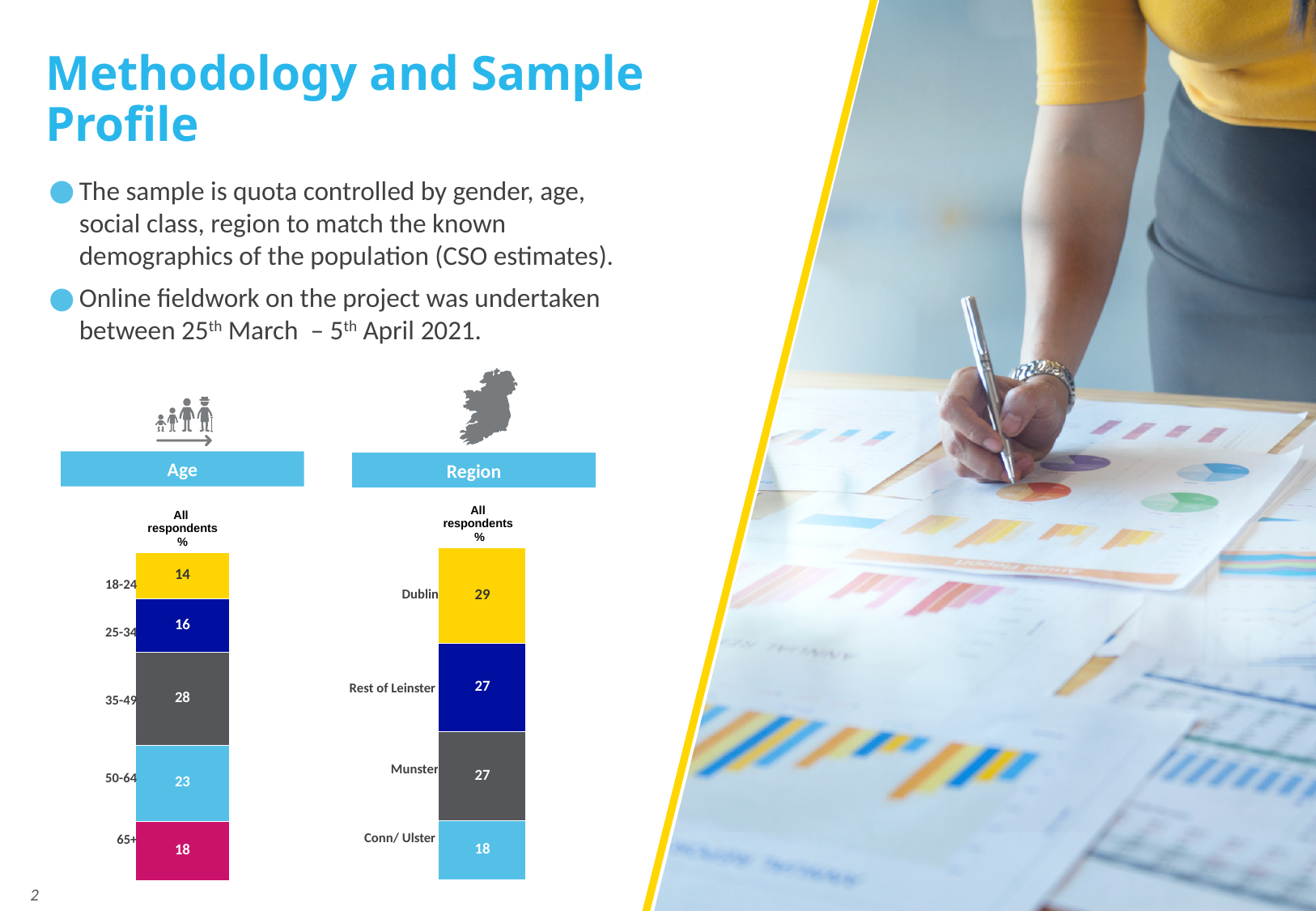
How many age groups are shown in the Age chart? 5 In the Age chart, which age group has the largest share of respondents? 35-49 What type of chart is used for the Region breakdown? Stacked bar chart In the Age chart, what percentage of all respondents are aged 35-49? 28 In the Region chart, which region has the smallest share of respondents? Conn/ Ulster In the Region chart, what percentage of all respondents are from Dublin? 29 In the Region chart, which is larger, the value for Dublin or the value for Munster? Dublin In the Region chart, what is the value for Conn/ Ulster? 18 In the Age chart, what is the difference between the 50-64 and 25-34 values? 7 In the Age chart, what is the value for the 65+ group? 18 In the Region chart, which region has the largest share of respondents? Dublin In the Age chart, which age group has the smallest share of respondents? 18-24